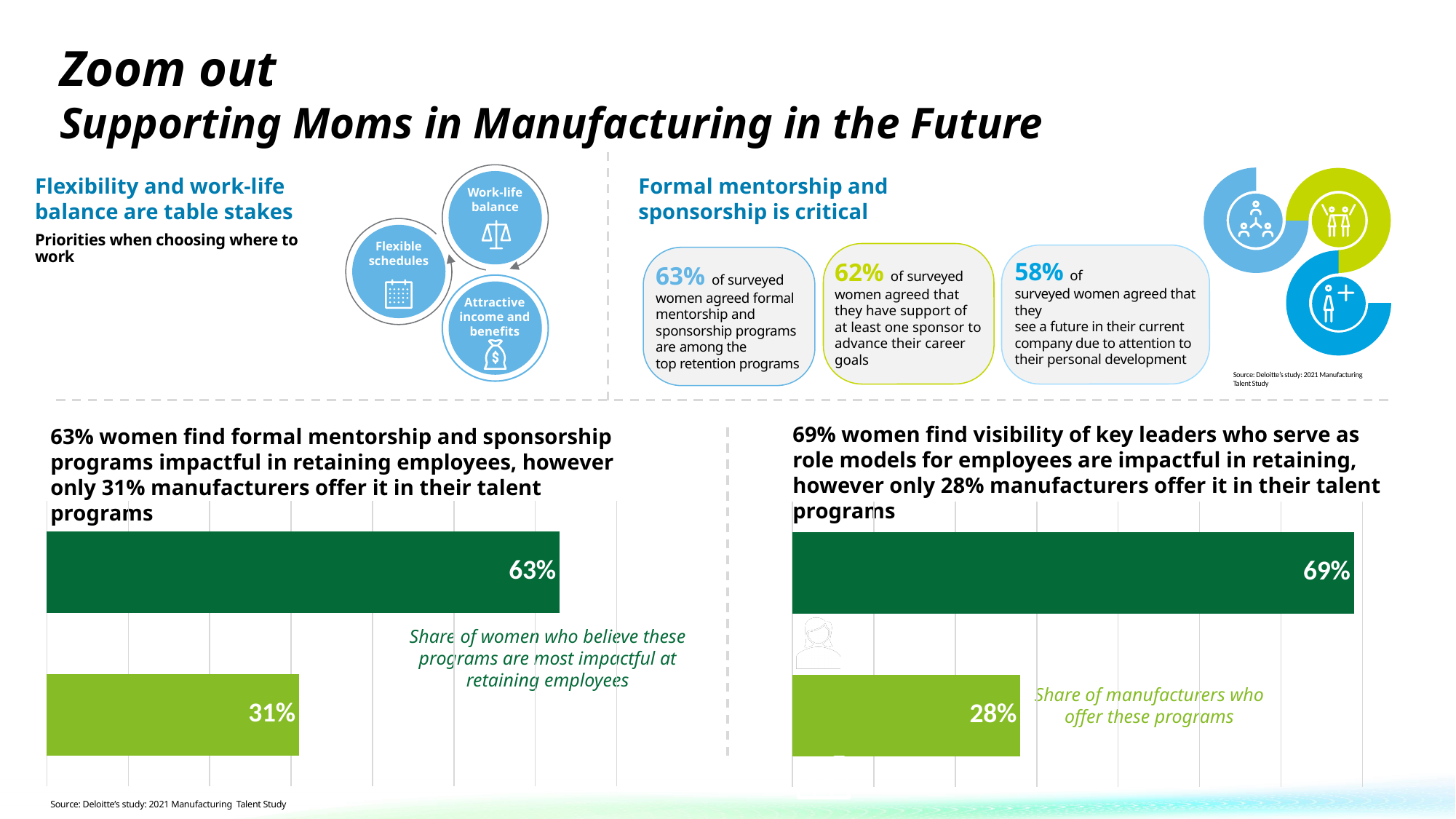
What type of chart is used at the bottom of the slide to show the 63% and 31% values? Bar chart In the right bar chart, what is the share of manufacturers who offer visibility of key leaders as role models in their talent programs? 28% How many bars are plotted in the left bar chart? 2 In the left bar chart, what is the share of women who believe formal mentorship and sponsorship programs are most impactful at retaining employees? 63% In the left bar chart, what is the difference in percentage points between the share of women who find the programs impactful and the share of manufacturers who offer them? 32 percentage points In the right bar chart, what is the difference in percentage points between the 69% and 28% bars? 41 percentage points In the left bar chart, which is larger: the share of women who believe the programs are impactful or the share of manufacturers who offer them? Share of women who believe the programs are impactful (63%) In the left bar chart, what is the share of manufacturers who offer formal mentorship and sponsorship programs? 31% In the right bar chart, what value is shown on the dark green bar for the share of women who find visibility of key leaders impactful in retaining employees? 69% In the bottom charts, what colour is the bar representing the share of manufacturers who offer these programs? Light green Comparing the two bottom bar charts, which chart shows the higher share of manufacturers offering the program: the left chart (mentorship and sponsorship) or the right chart (visibility of key leaders)? The left chart (31%) In the right bar chart, which bar has the highest value? Share of women who find the programs impactful (69%)